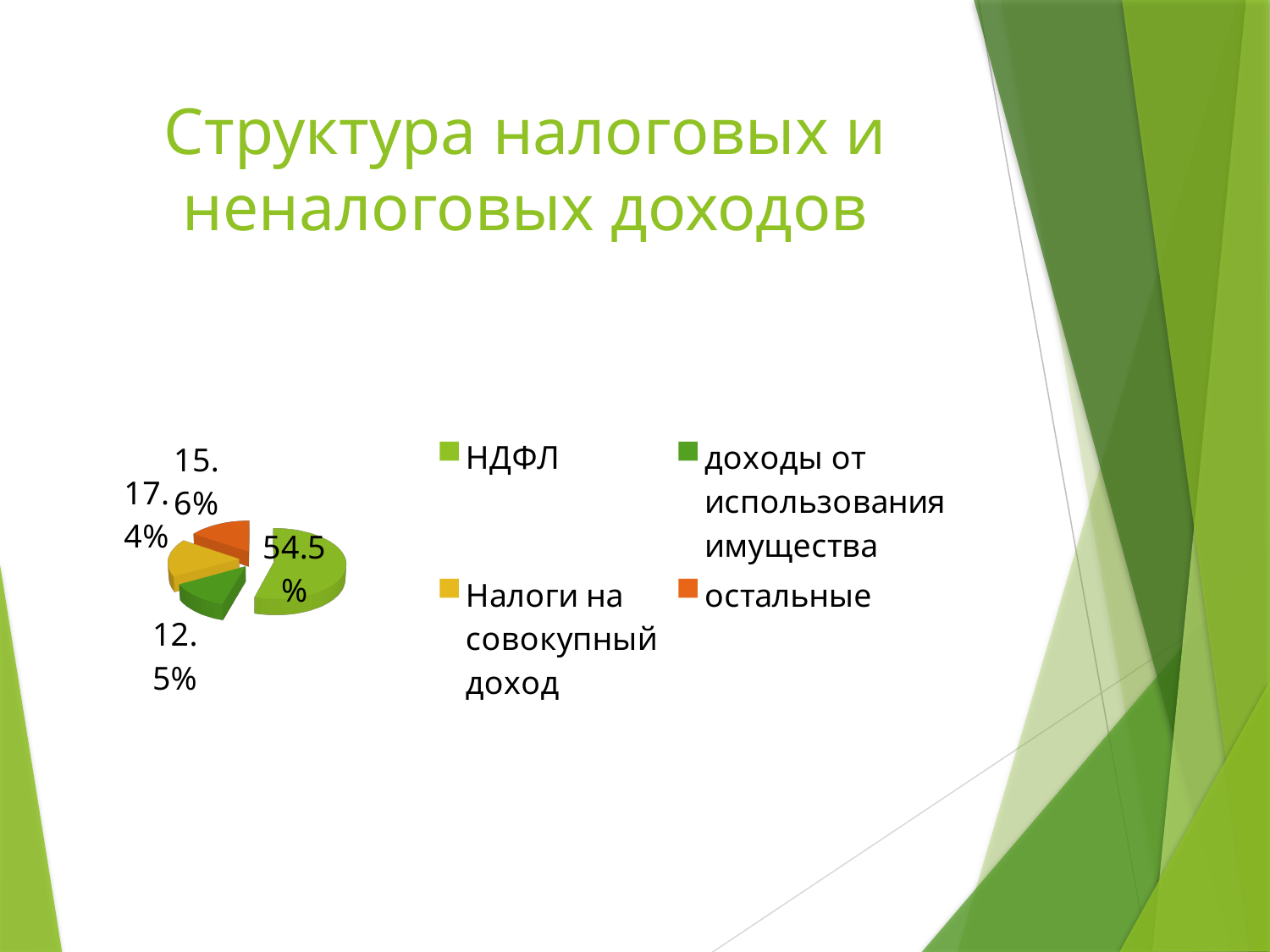
What is the share of Налоги на совокупный доход in the pie chart? 17.4% What is the title of the slide containing the pie chart? Структура налоговых и неналоговых доходов Which is larger: the share of Налоги на совокупный доход or the share of остальные? Налоги на совокупный доход What is the difference in percentage points between the НДФЛ slice and the остальные slice? 38.9 Which category has the smallest slice of the pie chart? доходы от использования имущества What is the share of остальные in the pie chart? 15.6% Which category has the largest slice of the pie chart? НДФЛ What kind of chart is shown on the slide? pie chart How many slices does the pie chart have? 4 How many entries does the legend list? 4 What is the share of доходы от использования имущества in the pie chart? 12.5% What is the share of НДФЛ in the pie chart? 54.5%